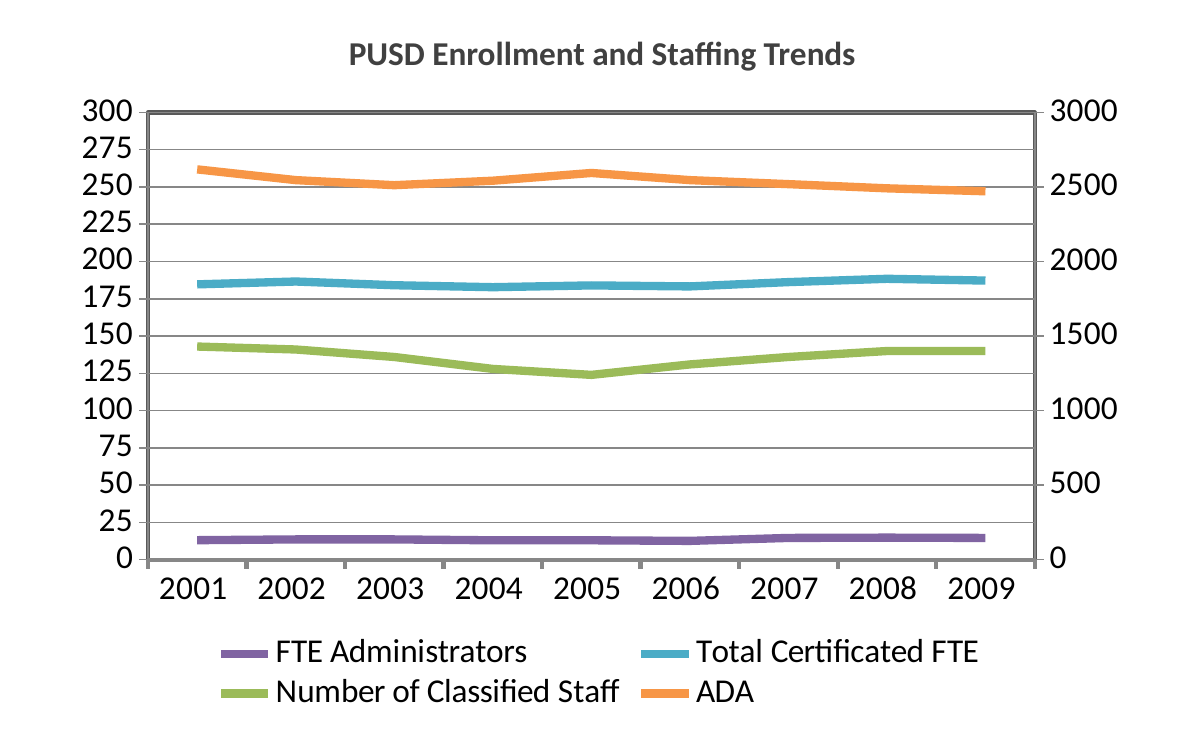
Is the value for Total Certificated FTE in 2001 greater or less than 175? greater Is the value for FTE Administrators in 2009 greater or less than 25? less Which year has the lowest value for Number of Classified Staff? 2005 How many series does the legend list? 4 Does the Number of Classified Staff rise or fall from 2001 to 2005? fall What kind of chart is shown on the slide? line chart What colour is the ADA line? orange How many years are shown along the x axis? 9 What is the title of the chart? PUSD Enrollment and Staffing Trends Is the value for Number of Classified Staff in 2005 greater or less than 150? less In 2005, which is larger: Total Certificated FTE or Number of Classified Staff? Total Certificated FTE